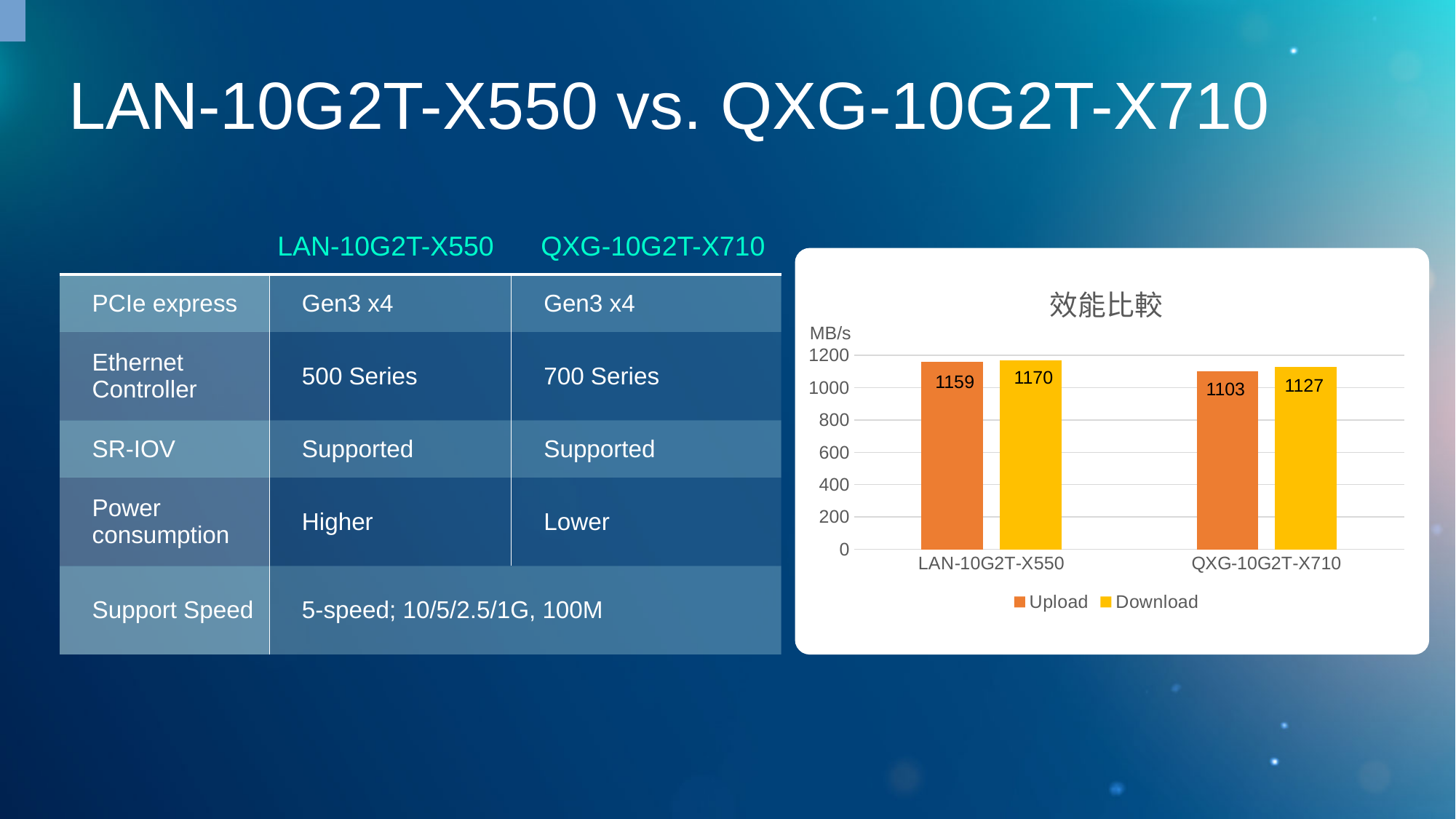
What is the Download value for LAN-10G2T-X550? 1170 What is the difference between the Upload values of LAN-10G2T-X550 and QXG-10G2T-X710? 56 Which is larger, the Download value for LAN-10G2T-X550 or the Download value for QXG-10G2T-X710? LAN-10G2T-X550 What type of chart is shown on the slide? Bar chart Which category has the highest Download value? LAN-10G2T-X550 What is the Download value for QXG-10G2T-X710? 1127 What is the difference between the Download and Upload values for QXG-10G2T-X710? 24 What is the Upload value for LAN-10G2T-X550? 1159 How many series does the chart legend list? 2 Which category has the lowest Upload value? QXG-10G2T-X710 What is the Upload value for QXG-10G2T-X710? 1103 How many categories are shown on the x axis of the chart? 2